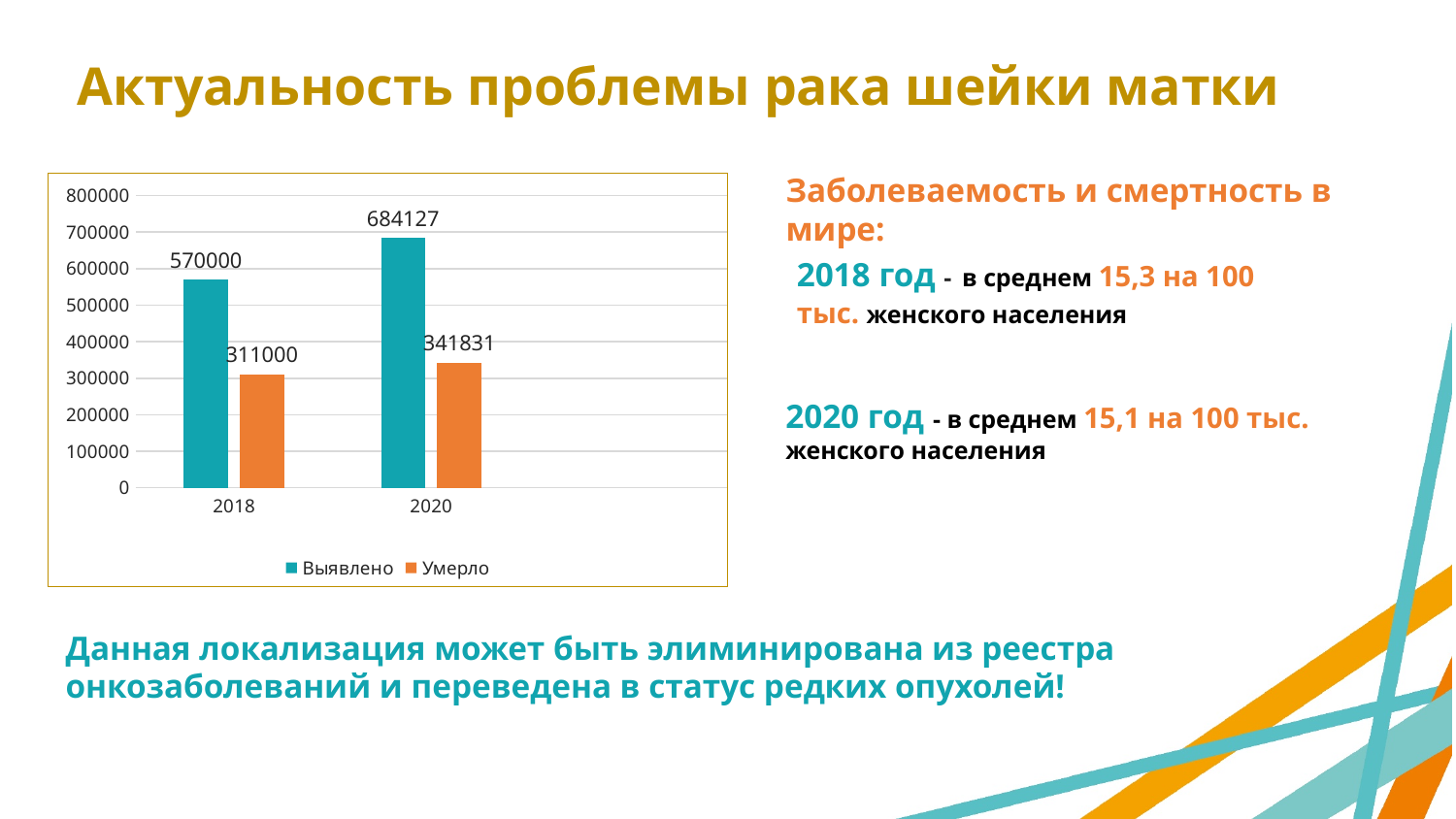
Does the value of Выявлено rise or fall from 2018 to 2020? Rise What is the difference between Выявлено in 2020 and Выявлено in 2018? 114127 What is the value of Выявлено for 2018? 570000 What is the value of Умерло for 2020? 341831 What is the value of Умерло for 2018? 311000 How many series does the legend list? 2 What is the difference between Умерло in 2020 and Умерло in 2018? 30831 Which year has the higher value for Выявлено? 2020 What is the value of Выявлено for 2020? 684127 What type of chart is shown on the slide? Bar chart How many categories are shown on the x axis? 2 What are the two legend entries of the chart? Выявлено, Умерло